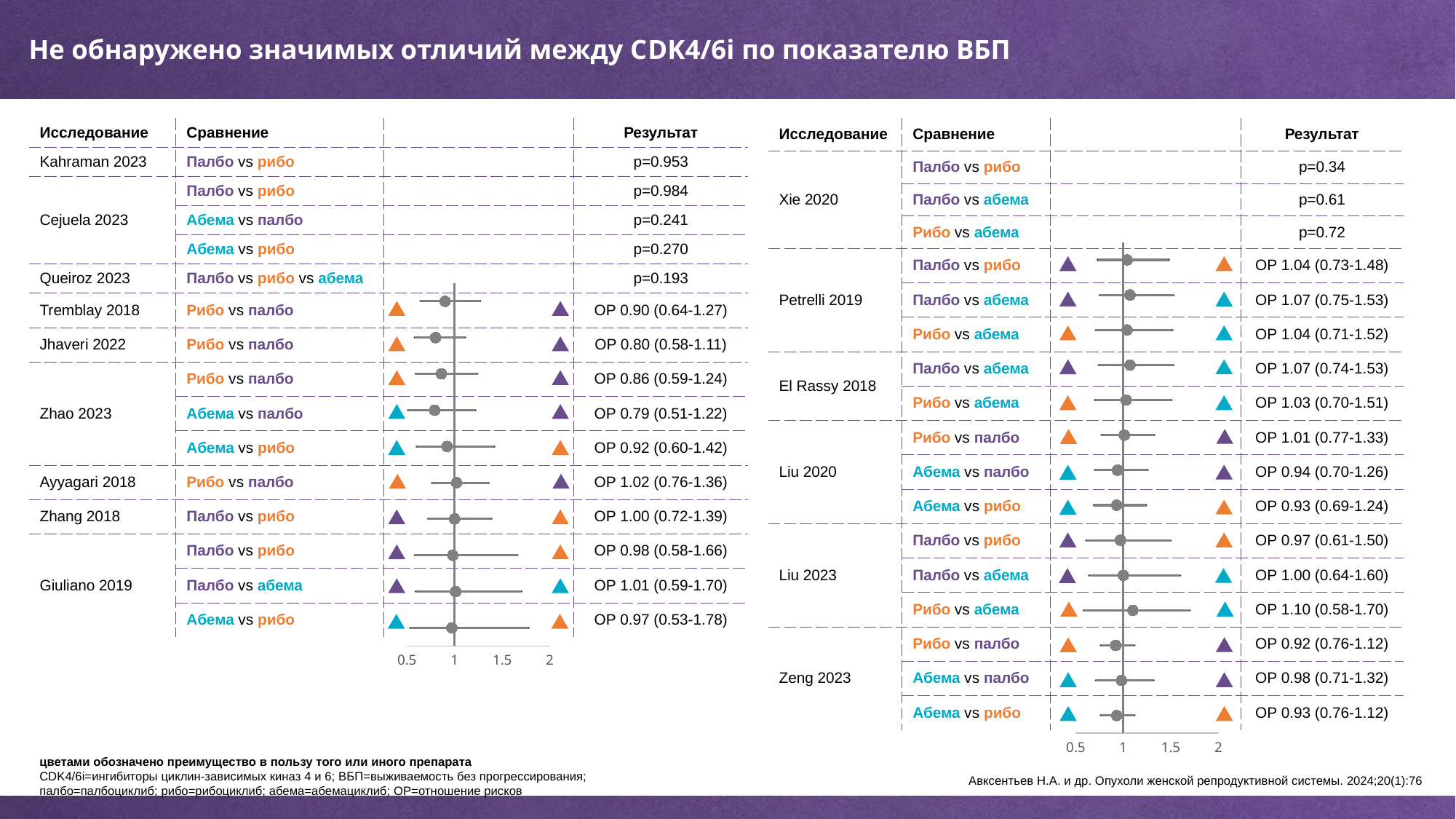
In the right chart, what p-value is reported for Xie 2020, Рибо vs абема? p=0.72 In the left chart, what is the result for Tremblay 2018 (Рибо vs палбо)? ОР 0.90 (0.64-1.27) In the left chart, what is the difference between the ОР point estimates for Ayyagari 2018 (1.02) and Jhaveri 2022 (0.80)? 0.22 What kind of chart is shown on the slide? Forest plot What tick values are shown on the x axis of the forest plots? 0.5, 1, 1.5, 2 In the left chart, which comparison has the lowest hazard ratio (ОР) point estimate? Zhao 2023, Абема vs палбо (ОР 0.79) In the right chart, for Petrelli 2019, which has the larger ОР point estimate: Палбо vs абема or Рибо vs абема? Палбо vs абема In the right chart, what is the result for Liu 2023, Рибо vs абема? ОР 1.10 (0.58-1.70) In the left chart, is the ОР point estimate for Zhao 2023 (Абема vs палбо) greater or less than 1? less In the left chart, what p-value is reported for Kahraman 2023 (Палбо vs рибо)? p=0.953 In the right chart, which comparison has the highest hazard ratio (ОР) point estimate? Liu 2023, Рибо vs абема (ОР 1.10) How many studies are listed in the right chart? 6